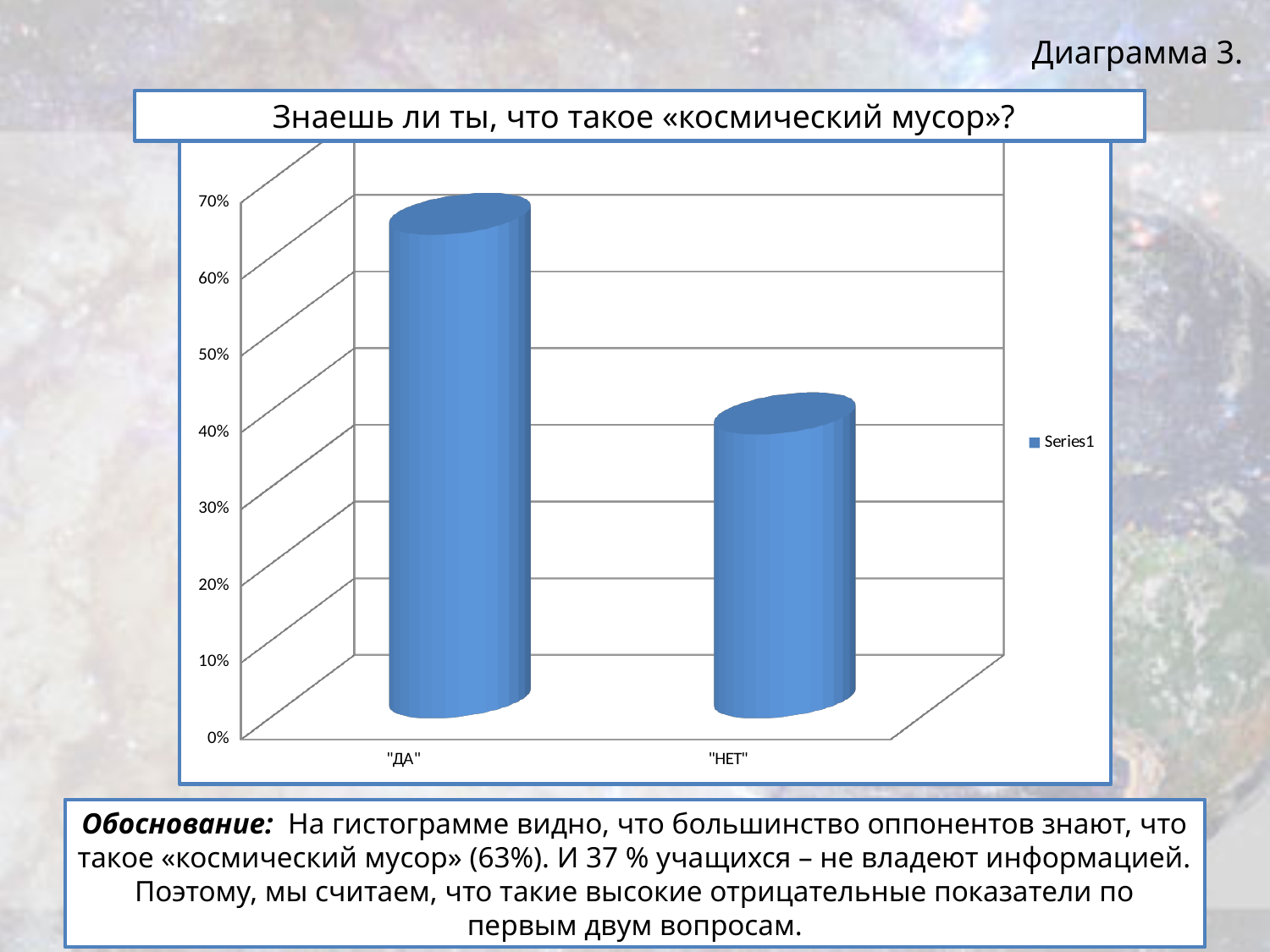
What series name is shown in the chart legend? Series1 Is the value for "ДА" greater or less than 50%? greater How many series does the chart legend list? 1 Which category has the highest value in the chart? "ДА" Is the value for "ДА" greater or less than 60%? greater How many categories are shown on the x axis of the chart? 2 Which is larger, the value for "ДА" or the value for "НЕТ"? "ДА" What is the title of the chart? Знаешь ли ты, что такое «космический мусор»? Is the value for "НЕТ" greater or less than 50%? less Which category has the lowest value in the chart? "НЕТ" What kind of chart is shown on the slide? bar chart